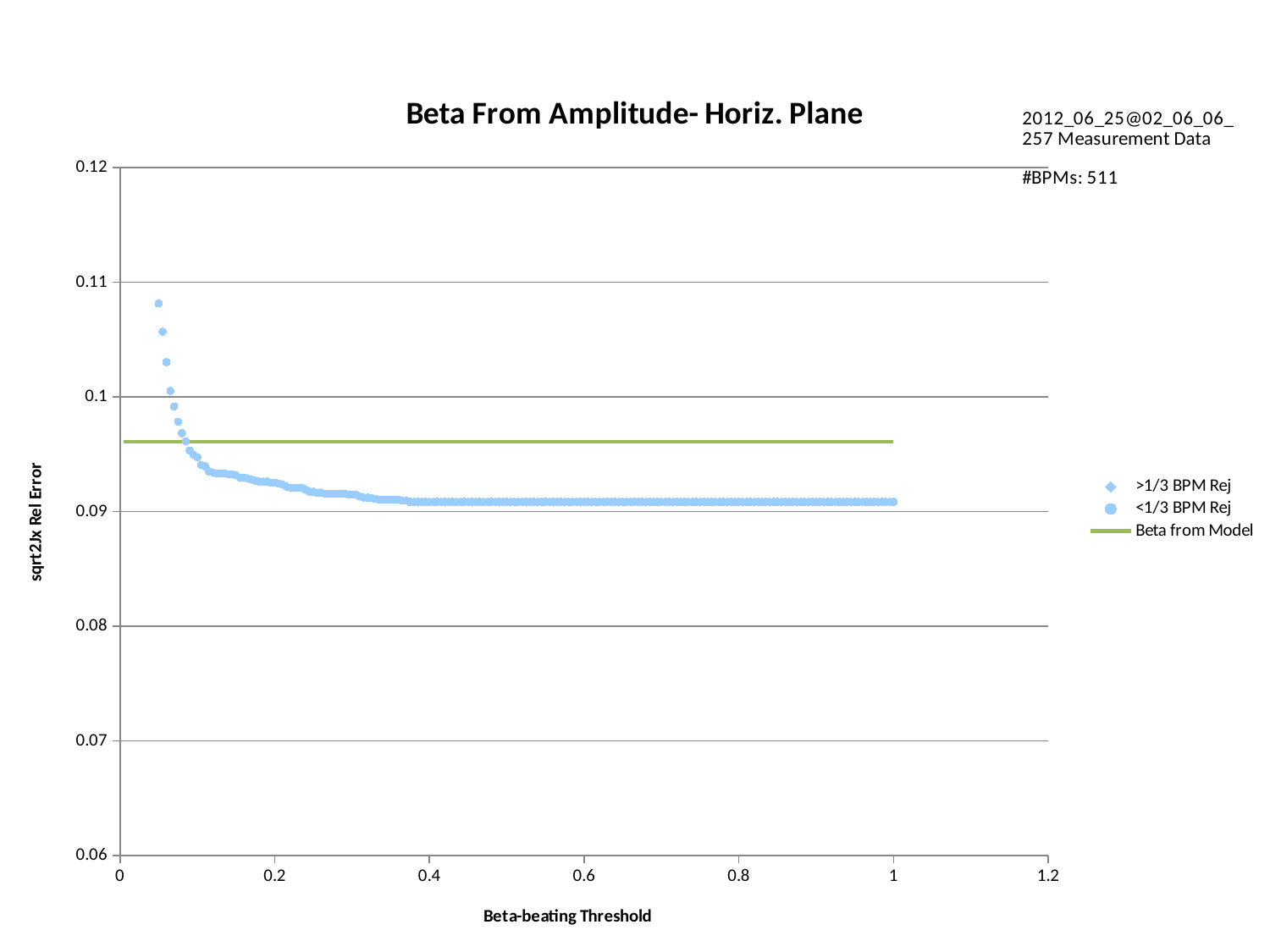
How many series does the chart's legend list? 3 How many BPMs are stated on the slide? 511 Is the Beta from Model line greater or less than 0.09? greater Do the <1/3 BPM Rej values rise or fall as the Beta-beating Threshold increases? fall Is the <1/3 BPM Rej value at the smallest Beta-beating Threshold greater or less than 0.1? greater What kind of chart is shown on the slide? scatter chart What is the label of the x axis? Beta-beating Threshold Which is larger at a Beta-beating Threshold of 0.05: the <1/3 BPM Rej value or the Beta from Model line? <1/3 BPM Rej Is the <1/3 BPM Rej value at a Beta-beating Threshold of 1 greater or less than 0.1? less What is the title of the chart? Beta From Amplitude- Horiz. Plane Which is larger at a Beta-beating Threshold of 0.6: the <1/3 BPM Rej value or the Beta from Model line? Beta from Model